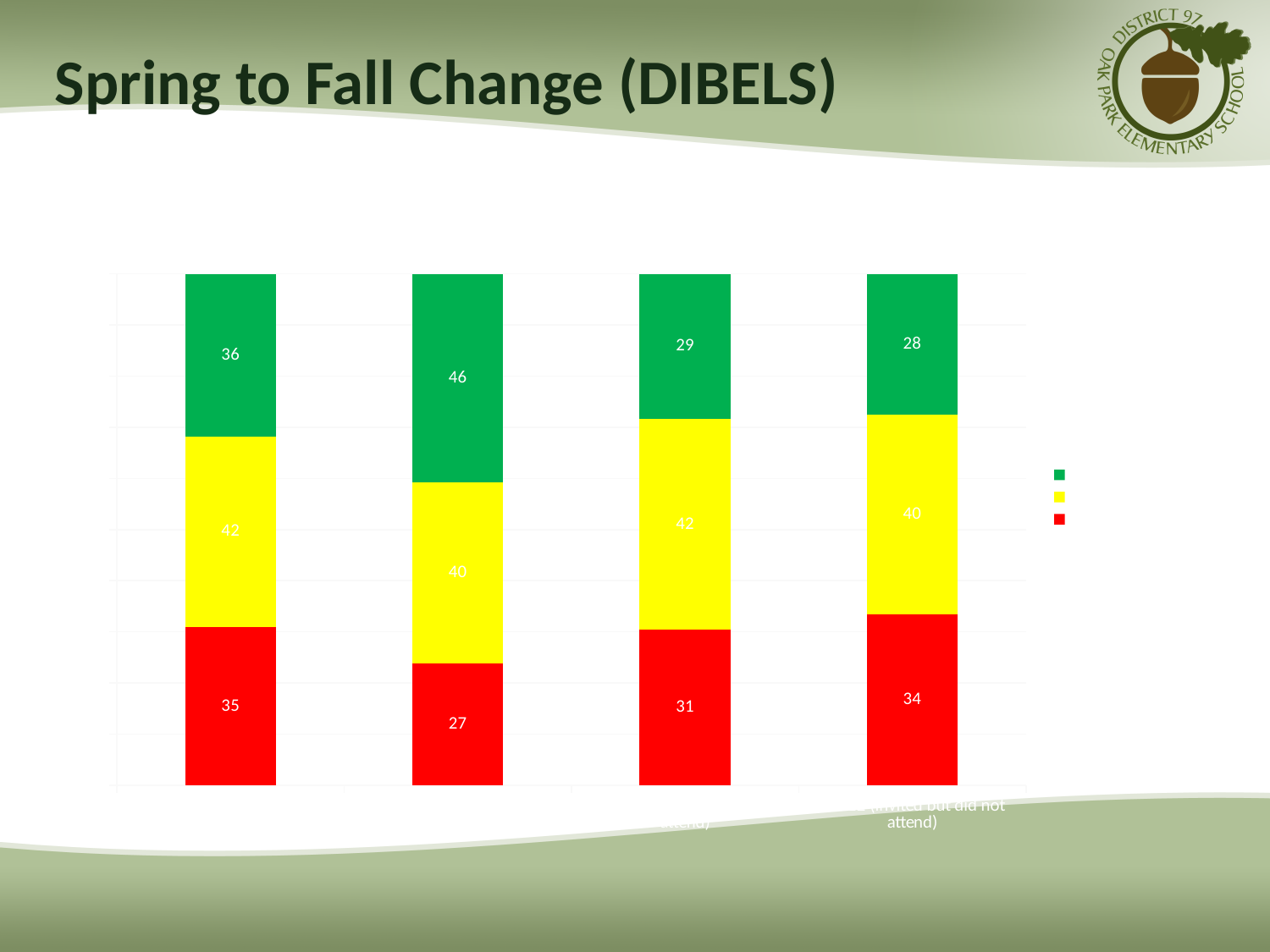
What kind of chart is shown on the slide? Stacked bar chart What is the value of the red segment in the second bar from the left? 27 What is the title of the slide containing the chart? Spring to Fall Change (DIBELS) What is the value of the yellow segment in the fourth (rightmost) bar? 40 What is the value of the green segment in the first (leftmost) bar? 36 Which bar has the smallest red segment? The second bar from the left How many series (colours) does the legend list? 3 What is the total of the three segments in the first (leftmost) bar? 113 Which bar has the largest green segment? The second bar from the left What is the difference between the green segment of the second bar and the green segment of the first bar? 10 How many bars are plotted in the chart? 4 Is the red segment larger in the third bar or the fourth bar? The fourth bar